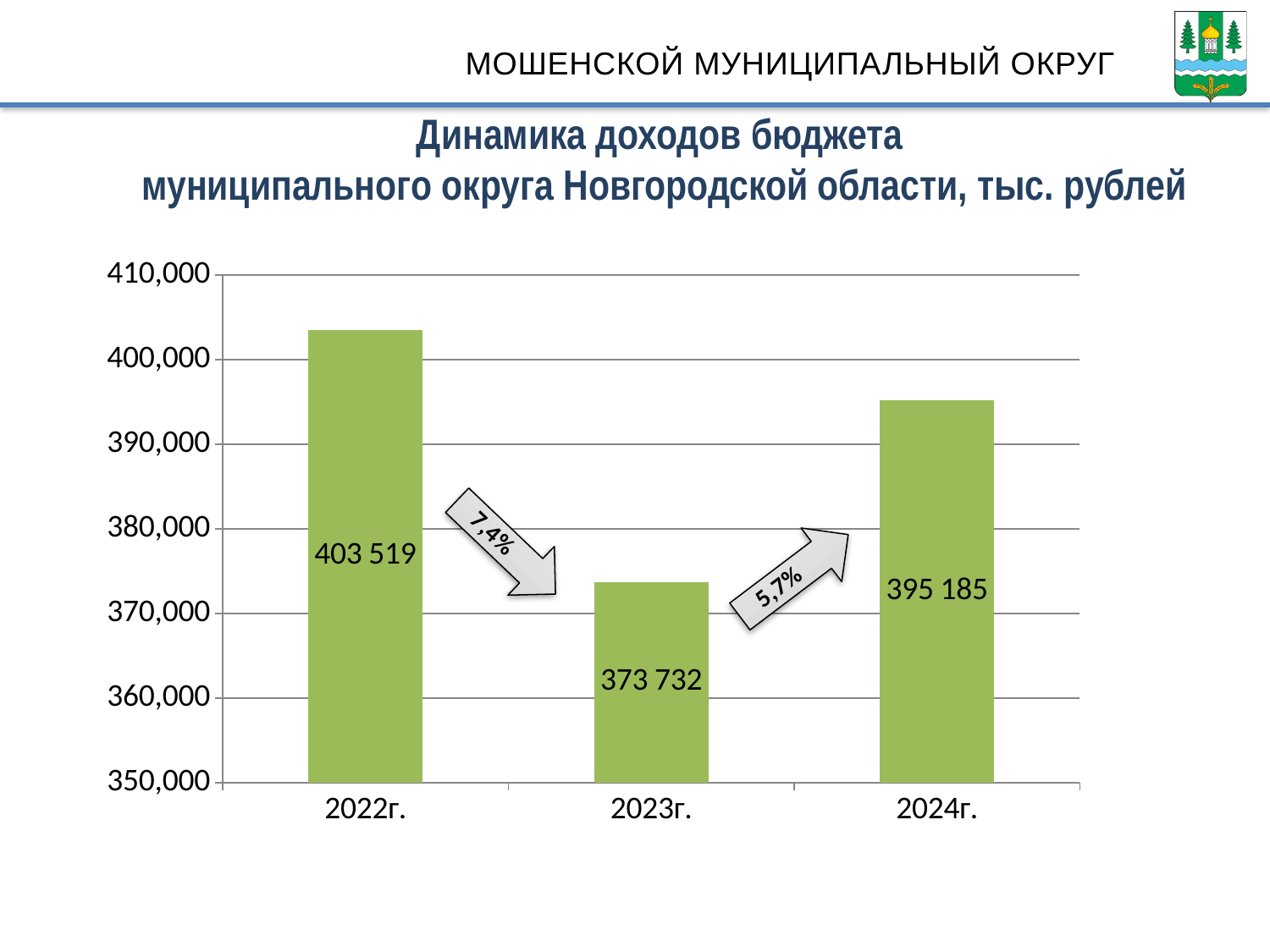
Which year has the highest budget revenue? 2022г. What is the budget revenue value shown for 2022г.? 403 519 What is the difference between the 2022г. and 2023г. values? 29 787 Is the value for 2023г. greater or less than 380,000? less Which is larger, the value for 2022г. or the value for 2024г.? 2022г. What kind of chart is shown on the slide? bar chart Which year has the lowest budget revenue? 2023г. What percentage change is shown by the arrow between 2023г. and 2024г.? 5,7% How many years are shown on the chart? 3 What is the budget revenue value shown for 2023г.? 373 732 What is the budget revenue value shown for 2024г.? 395 185 What is the difference between the 2024г. and 2023г. values? 21 453